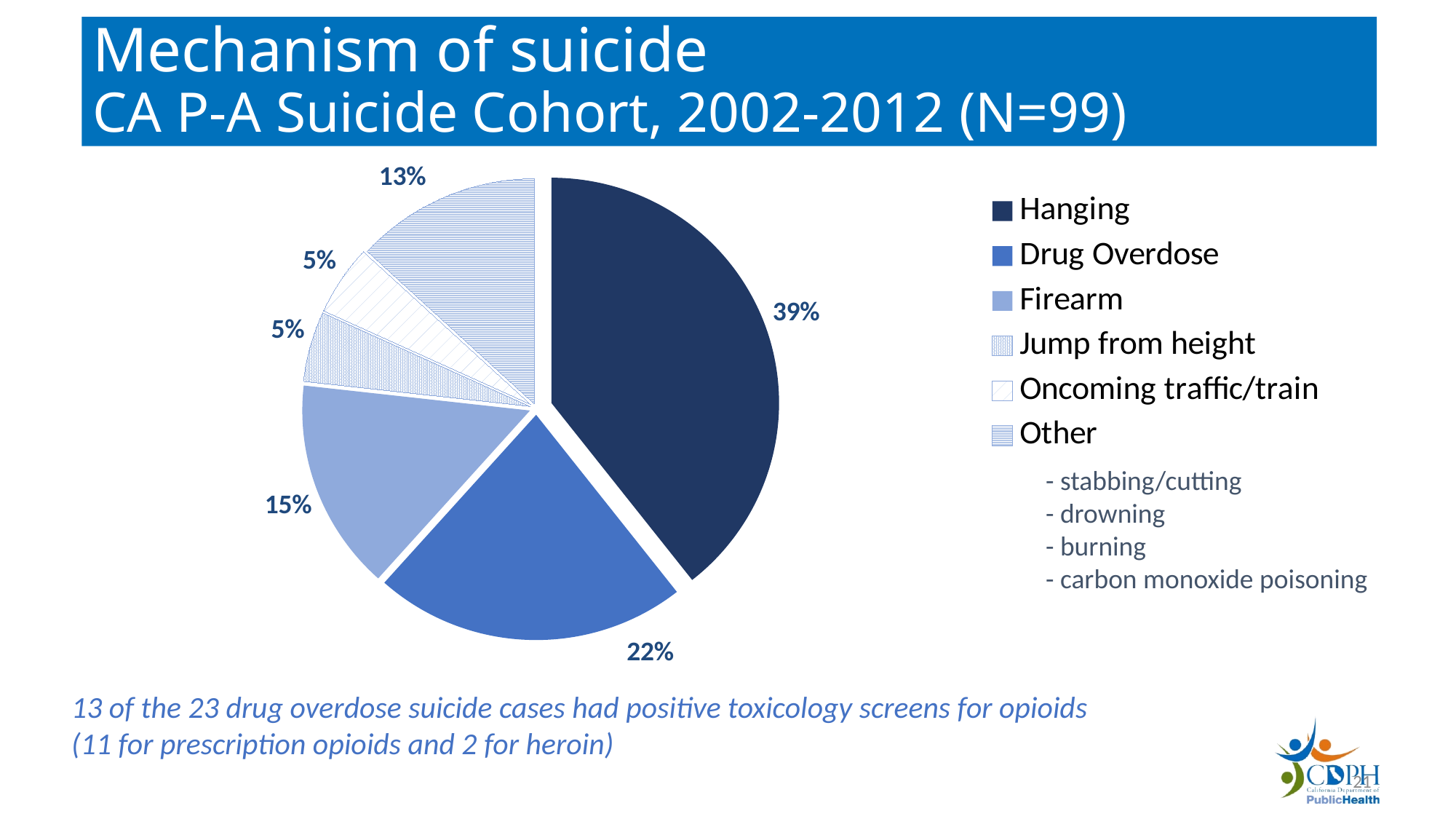
What is the title of the chart on the slide? Mechanism of suicide CA P-A Suicide Cohort, 2002-2012 (N=99) Which is larger, the share for Firearm or the share for Other? Firearm What percentage is shown for Firearm? 15% What percentage is shown for Drug Overdose? 22% What percentage is shown for Jump from height? 5% What is the combined percentage of Jump from height and Oncoming traffic/train? 10% What is the difference in percentage points between Hanging and Drug Overdose? 17 What percentage is shown for Other? 13% Which mechanism has the largest slice of the pie? Hanging What share of the pie does Hanging account for? 39% How many categories does the legend list? 6 What type of chart is shown on the slide? pie chart